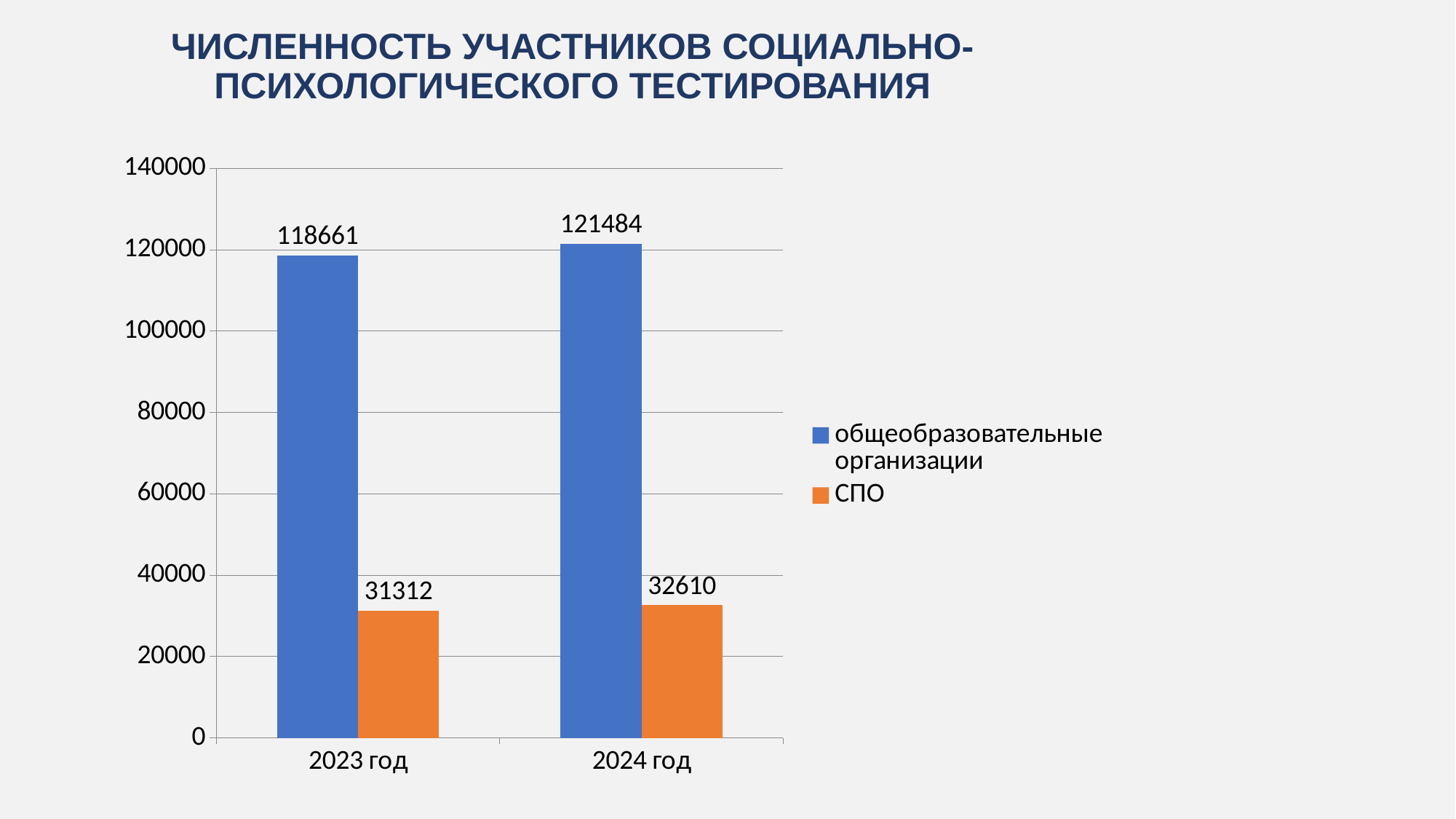
Which bar has the lowest value on the chart? СПО, 2023 год What type of chart is shown on the slide? Bar chart What is the difference between общеобразовательные организации and СПО in 2024 год? 88874 By how much did the value for общеобразовательные организации increase from 2023 год to 2024 год? 2823 What is the value for общеобразовательные организации in 2023 год? 118661 What is the value for общеобразовательные организации in 2024 год? 121484 What is the value for СПО in 2024 год? 32610 How many series does the legend list? 2 What is the value for СПО in 2023 год? 31312 Which is larger in 2023 год: общеобразовательные организации or СПО? общеобразовательные организации Does the value for СПО rise or fall from 2023 год to 2024 год? Rise Which bar has the highest value on the chart? общеобразовательные организации, 2024 год